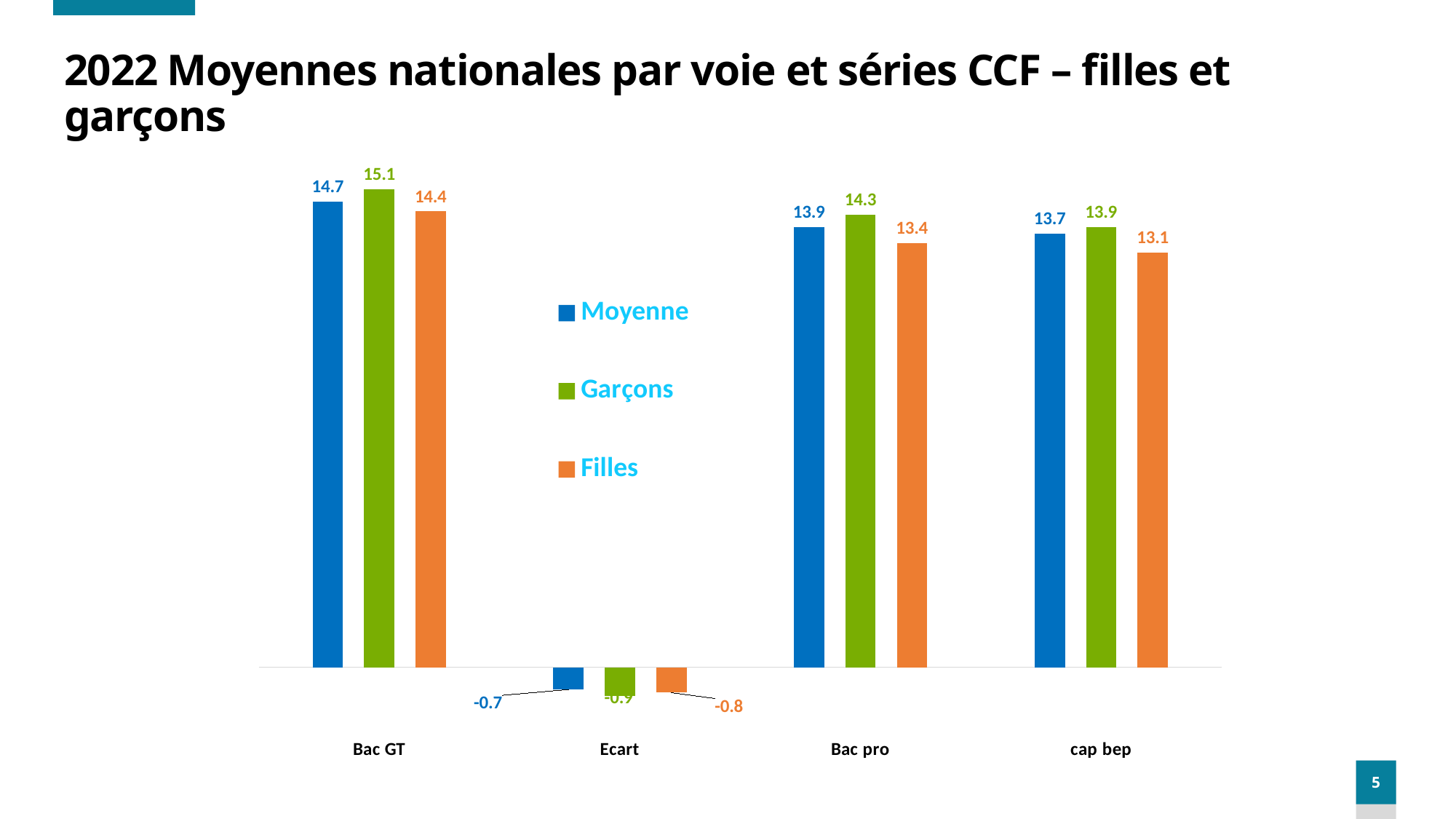
How many series does the legend list? 3 Which is larger for Bac pro, the Moyenne value or the Garçons value? Garçons How many categories are shown on the x axis? 4 What is the Garçons value for Bac GT? 15.1 What is the Filles value for Ecart? -0.8 Which category has the highest Garçons value? Bac GT Which category has the lowest Filles value? Ecart What is the Moyenne value for cap bep? 13.7 What is the difference between the Garçons and Filles values for cap bep? 0.8 Which series is shown in orange in the legend? Filles What kind of chart is shown on the slide? Bar chart What is the Filles value for Bac pro? 13.4